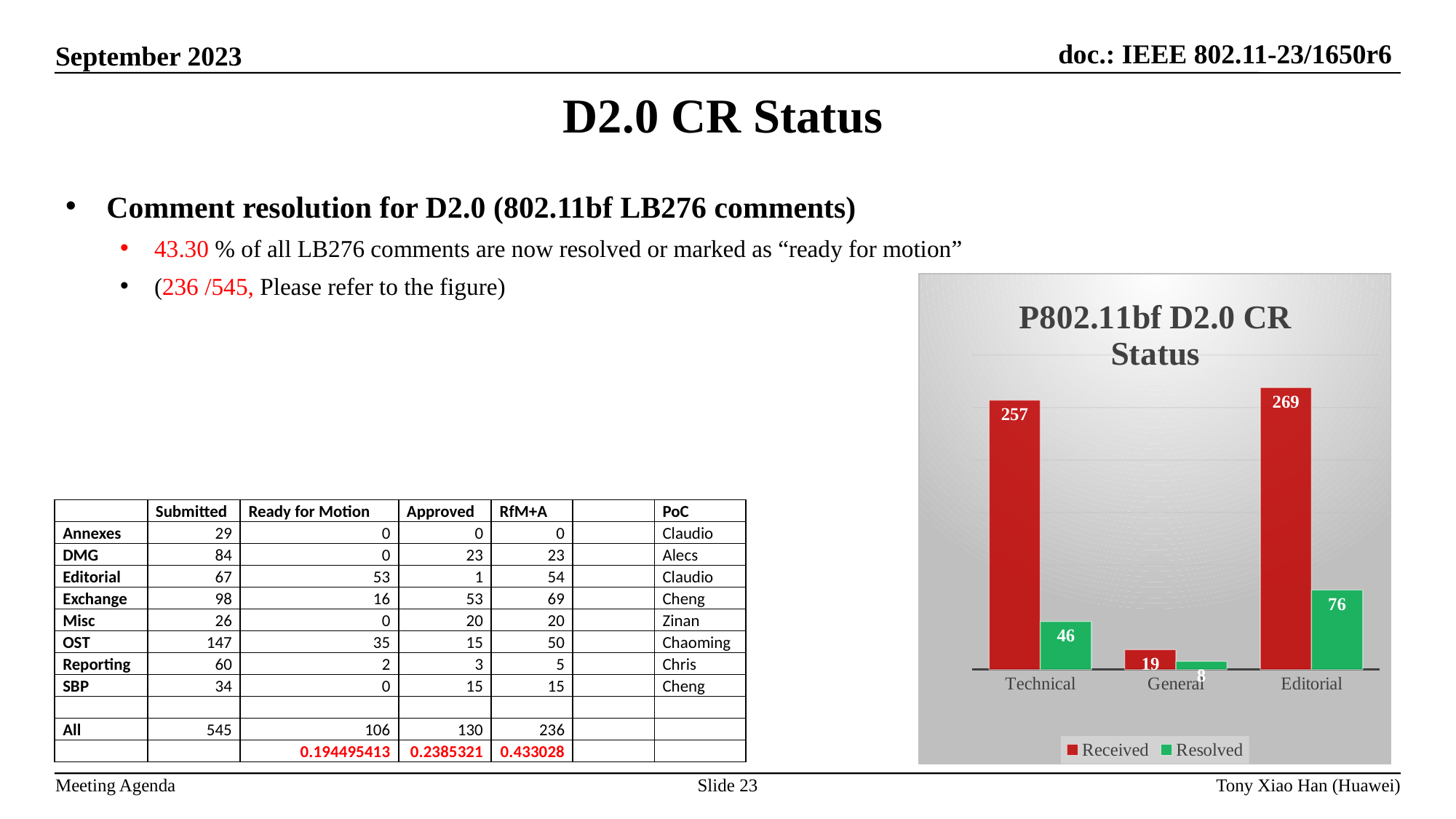
What is the Resolved value for Editorial? 76 What is the chart's title? P802.11bf D2.0 CR Status Which category has the lowest Resolved value? General What is the Received value for General? 19 What is the difference between the Received values for Editorial and Technical? 12 How many series does the chart legend list? 2 What type of chart is shown on the slide? bar chart Which colour represents the Resolved series in the chart? green Which category has the highest Received value? Editorial Which is larger, the Resolved value for Technical or the Resolved value for Editorial? Editorial What is the Received value for Technical? 257 How many categories are shown on the x axis of the chart? 3